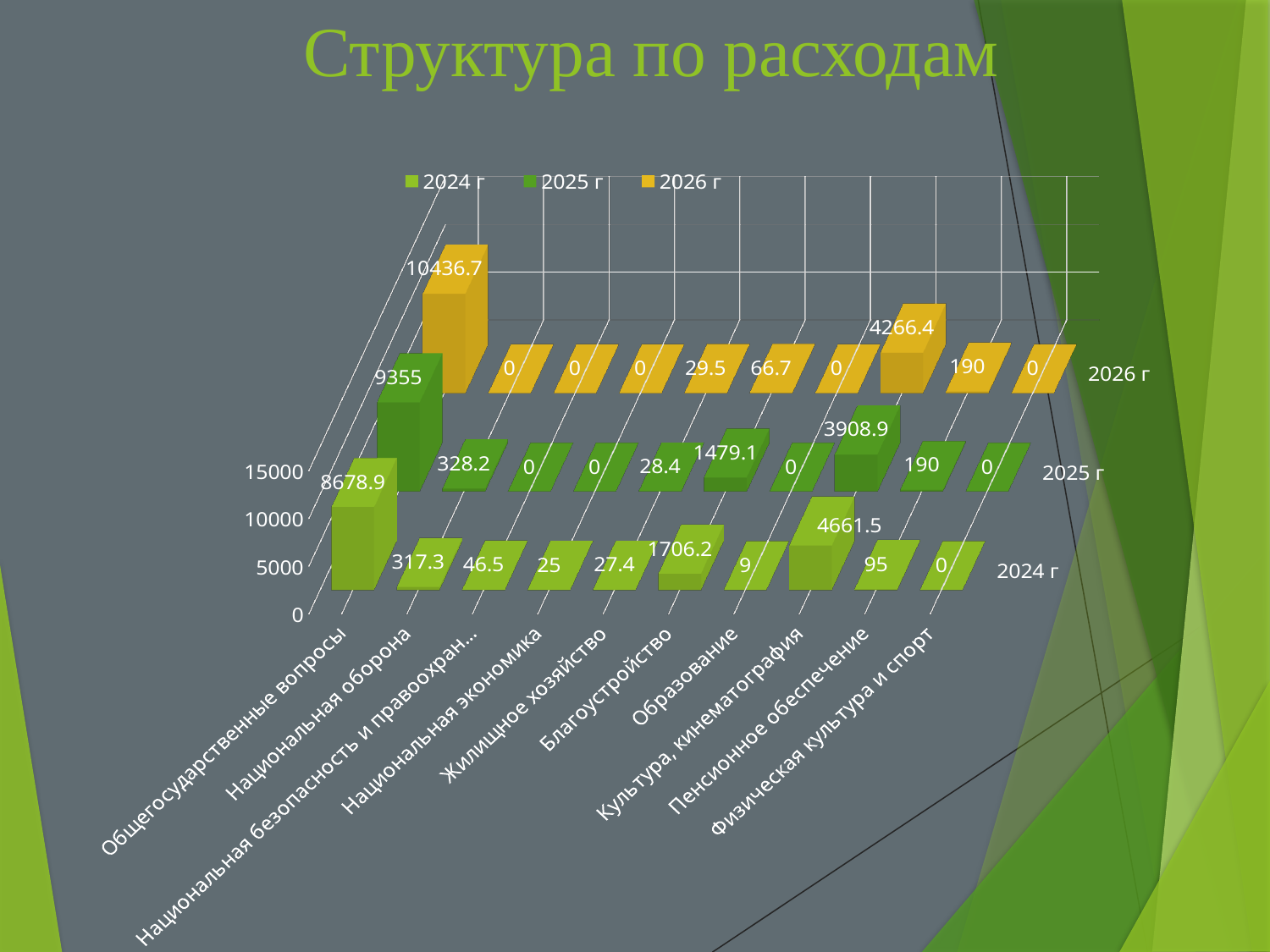
What is the value for Культура, кинематография in the 2025 г series? 3908.9 Which is larger for Культура, кинематография: the 2024 г value or the 2026 г value? 2024 г What is the value for Пенсионное обеспечение in the 2026 г series? 190 What is the difference between the 2026 г and 2024 г values for Общегосударственные вопросы? 1757.8 What is the value for Благоустройство in the 2024 г series? 1706.2 How many categories are shown on the x axis? 10 Which category has the highest value in the 2026 г series? Общегосударственные вопросы What is the title of the chart? Структура по расходам What is the value for Общегосударственные вопросы in the 2026 г series? 10436.7 What kind of chart is shown on the slide? bar chart What is the value for Общегосударственные вопросы in the 2024 г series? 8678.9 How many series does the legend list? 3